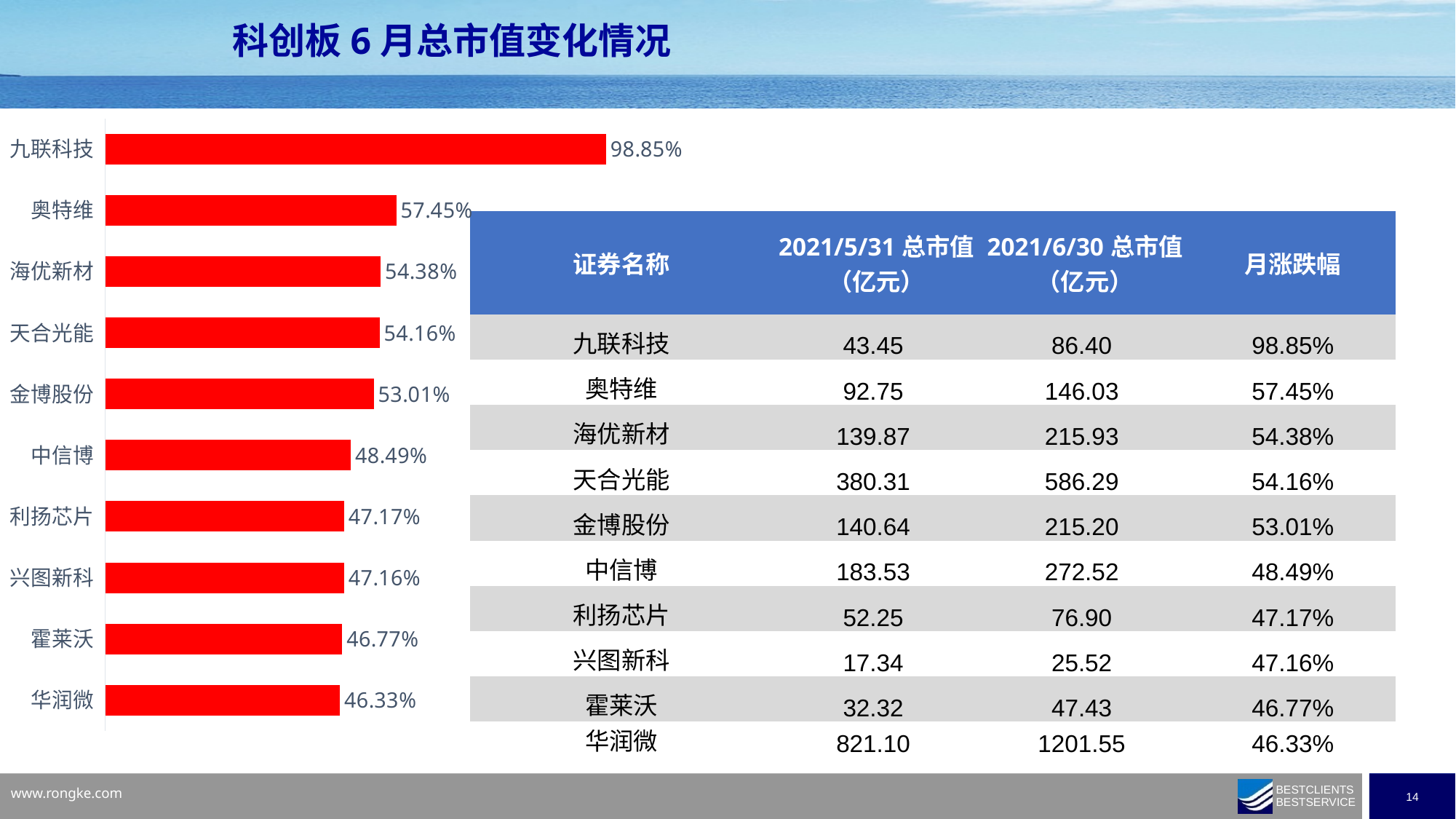
Which company has the lowest value in the bar chart? 华润微 What is the title of the slide containing the bar chart? 科创板 6 月总市值变化情况 What is the value shown for 九联科技 in the bar chart? 98.85% Do the bar values increase or decrease going from the top bar to the bottom bar? decrease In the bar chart, which is larger: the value for 奥特维 or the value for 金博股份? 奥特维 What is the value shown for 中信博 in the bar chart? 48.49% Which company has the highest value in the bar chart? 九联科技 What is the difference between the values for 九联科技 and 奥特维 in the bar chart? 41.40 percentage points What kind of chart is shown on the slide? bar chart What is the value shown for 华润微 in the bar chart? 46.33% How many companies are plotted in the bar chart? 10 What is the difference between the values for 海优新材 and 天合光能 in the bar chart? 0.22 percentage points